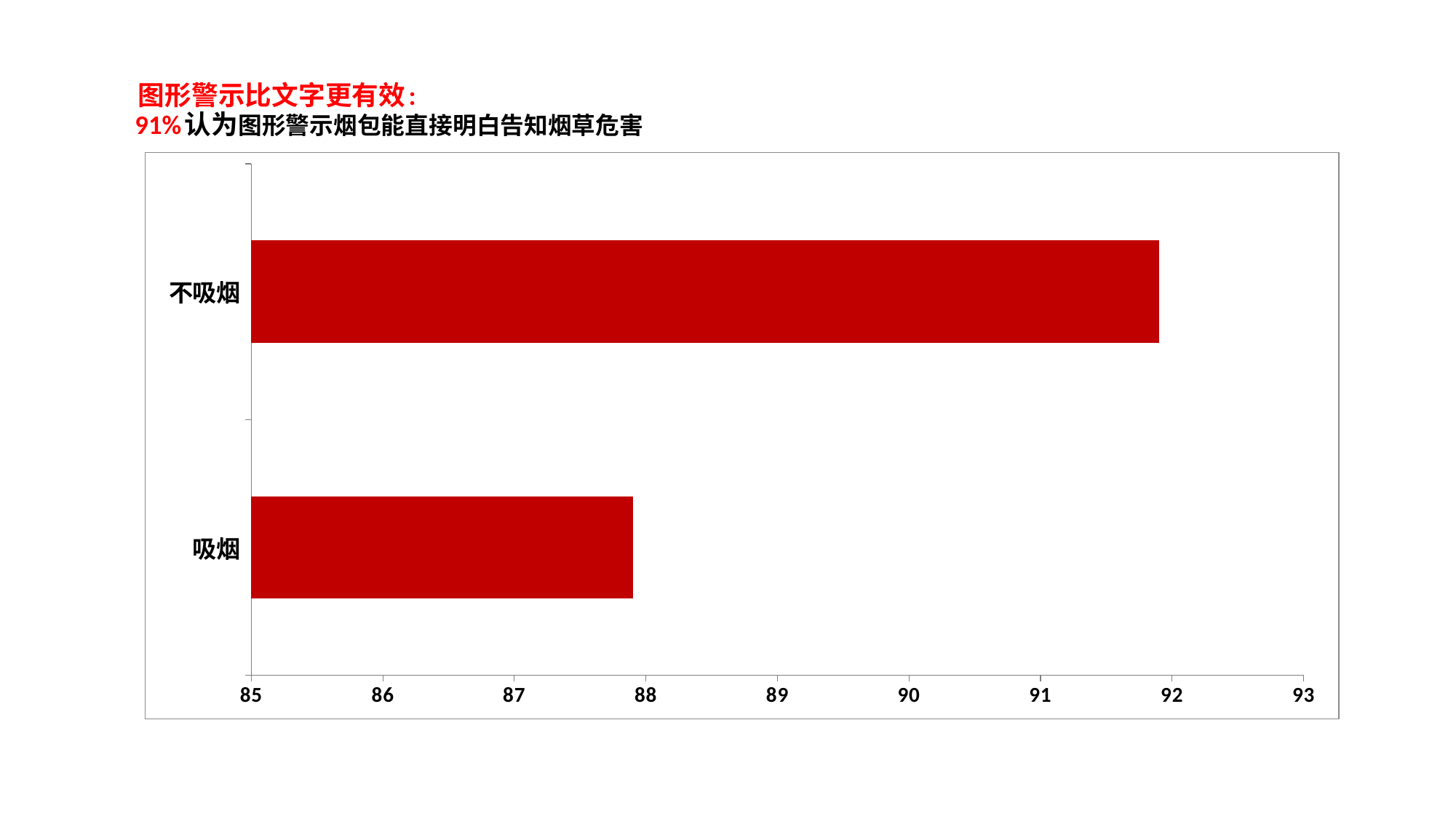
What is the lowest value shown on the horizontal axis of the chart? 85 Which is larger, the value for 不吸烟 or the value for 吸烟? 不吸烟 Which category has the lowest value in the chart? 吸烟 Is the value for 吸烟 greater or less than 87? greater Which category has the highest value in the chart? 不吸烟 Is the value for 不吸烟 greater or less than 91? greater What colour are the bars in the chart? red Is the value for 吸烟 greater or less than 89? less What kind of chart is shown on the slide? bar chart How many categories are plotted in the chart? 2